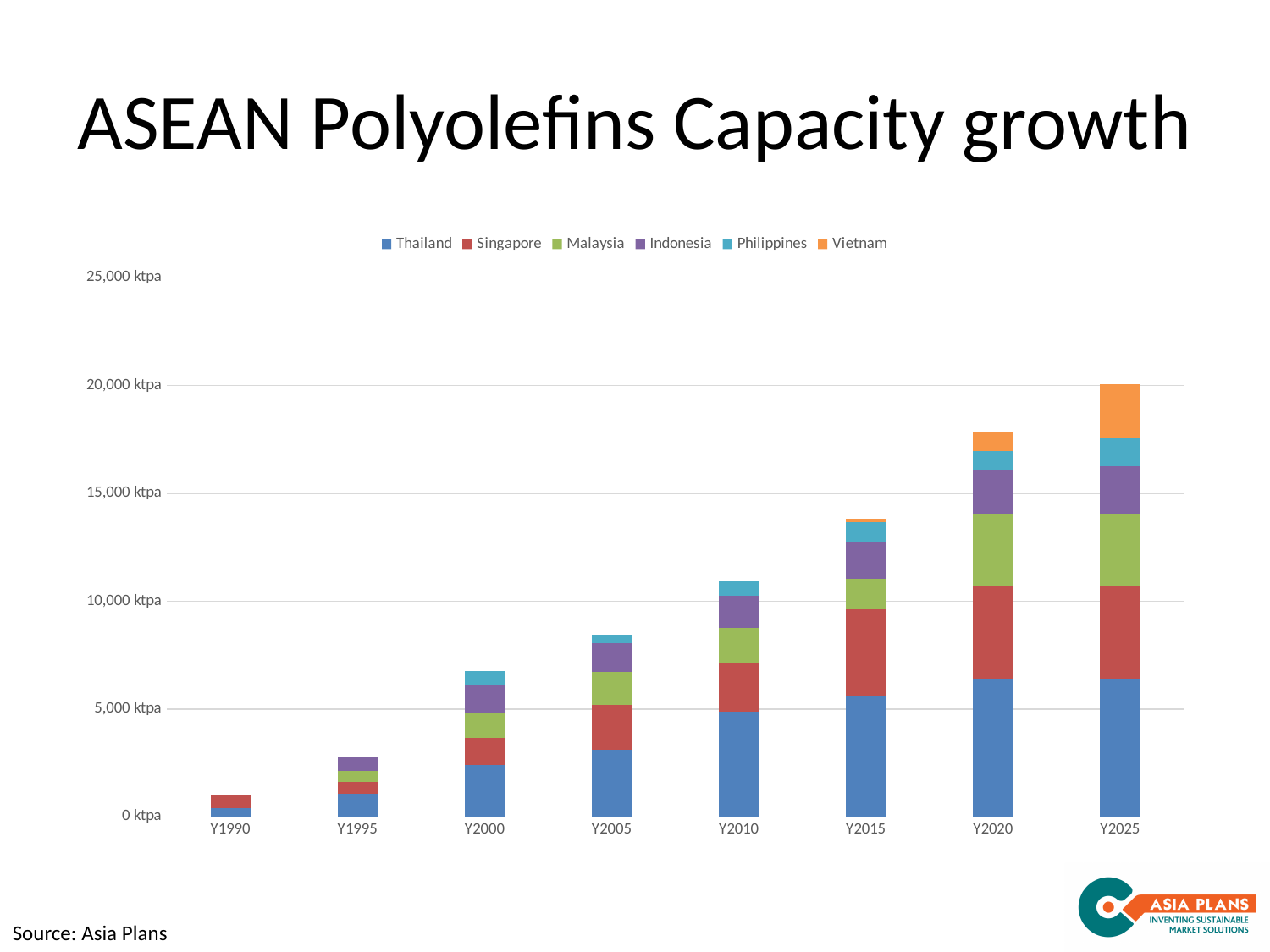
Which year has the highest total capacity? Y2025 How many year categories are shown on the x axis? 8 Which country is listed first in the legend? Thailand Which year has the lowest total capacity? Y1990 Is the total capacity for Y2005 greater or less than 10,000 ktpa? less How many series does the legend list? 6 What kind of chart is shown on the slide? Stacked bar chart Which year has a larger total capacity, Y2005 or Y2015? Y2015 Is the total capacity for Y2000 greater or less than 5,000 ktpa? greater Do the total capacity values rise or fall from Y1990 to Y2025? Rise What is the title of the chart? ASEAN Polyolefins Capacity growth Is the total capacity for Y2020 greater or less than 15,000 ktpa? greater